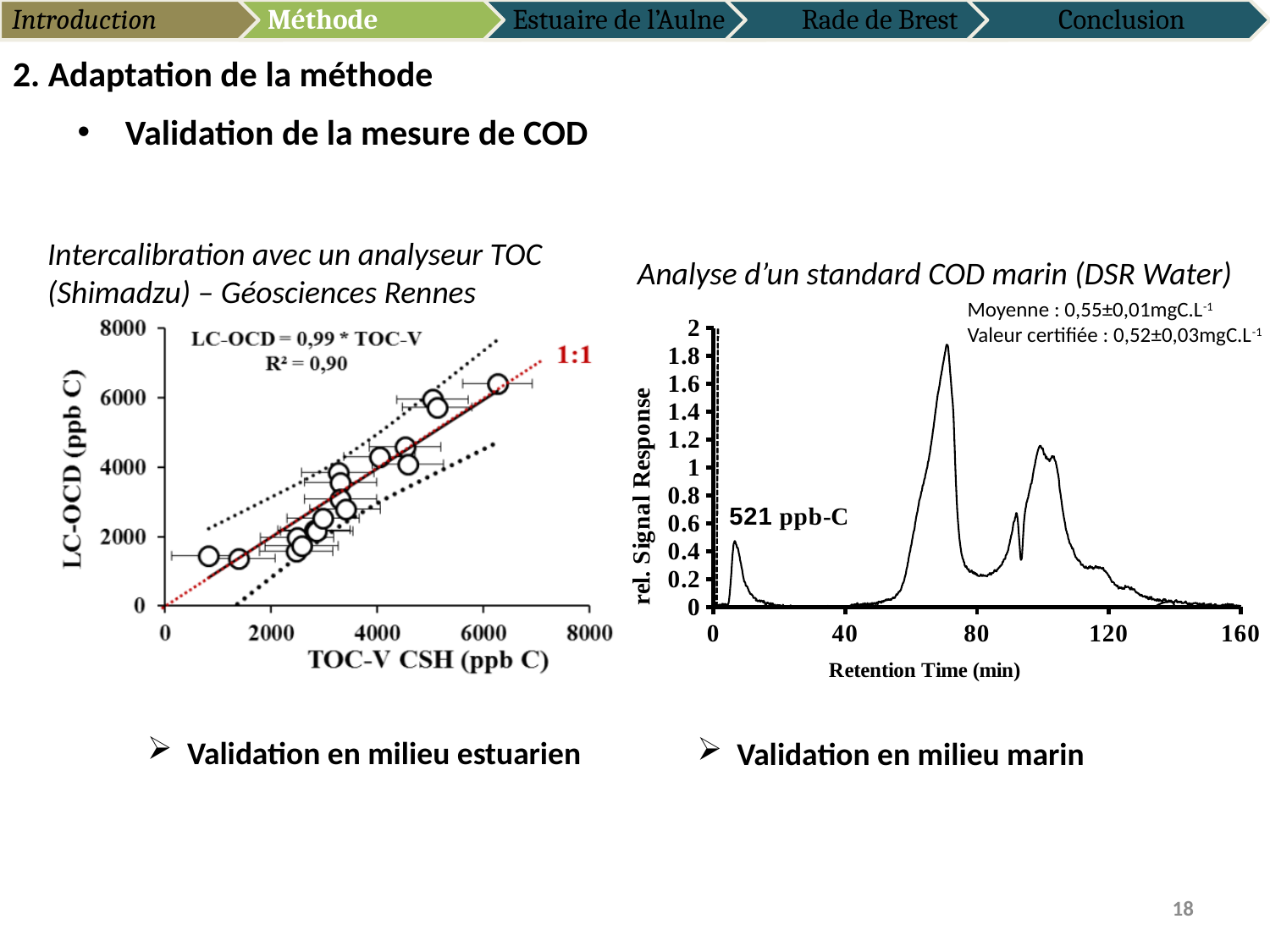
On the right chart, what concentration label is printed next to the first peak? 521 ppb-C On the right chart, what is the label of the x axis? Retention Time (min) On the right chart, what is the maximum value shown on the y axis? 2 On the right chart, is the height of the tallest peak (near 70 min) greater or less than 1.6? greater On the right chart, which peak is higher: the one near 70 min or the one near 100 min? the one near 70 min On the left chart, what is the label of the x axis? TOC-V CSH (ppb C) On the right chart, is the height of the peak near 100 min greater or less than 1.4? less What kind of chart is the left chart (Intercalibration avec un analyseur TOC)? scatter plot On the right chart, is the height of the first small peak (near 7 min) greater or less than 0.6? less What kind of chart is the right chart (Analyse d'un standard COD marin)? line chart On the right chart, what is the maximum retention time shown on the x axis? 160 On the left chart, what is the R² value printed on the plot? R² = 0,90